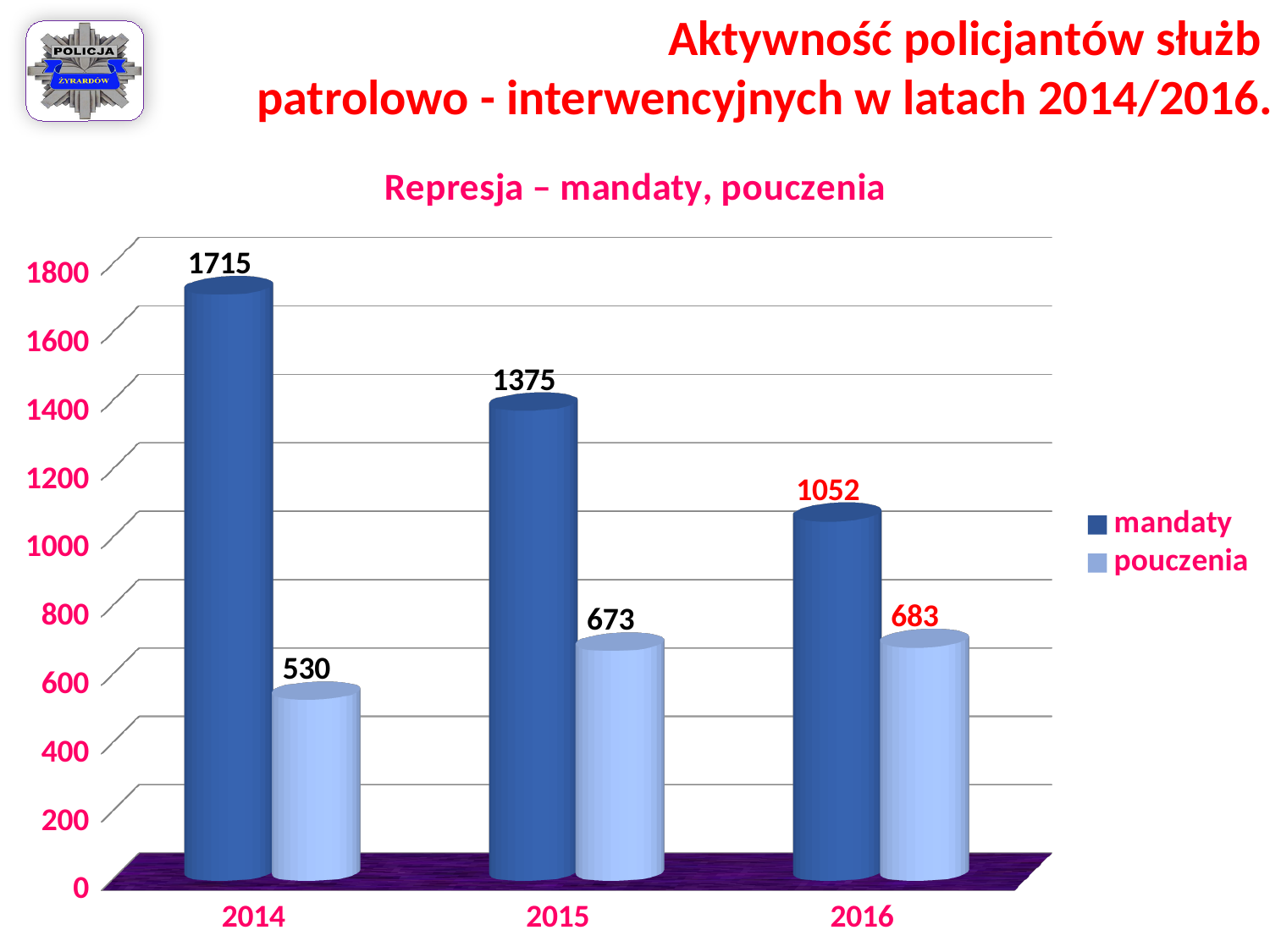
What kind of chart is shown on the slide? bar chart In which year is the value of mandaty highest? 2014 What is the difference between mandaty and pouczenia in 2015? 702 In which year is the value of pouczenia lowest? 2014 What is the value of pouczenia in 2016? 683 How many series does the legend list? 2 What is the value of mandaty in 2016? 1052 How many years are shown on the x axis? 3 Which is larger: mandaty in 2015 or mandaty in 2016? mandaty in 2015 What is the value of mandaty in 2014? 1715 Do the values of mandaty rise or fall from 2014 to 2016? fall Is the value of pouczenia in 2015 greater or less than 600? greater